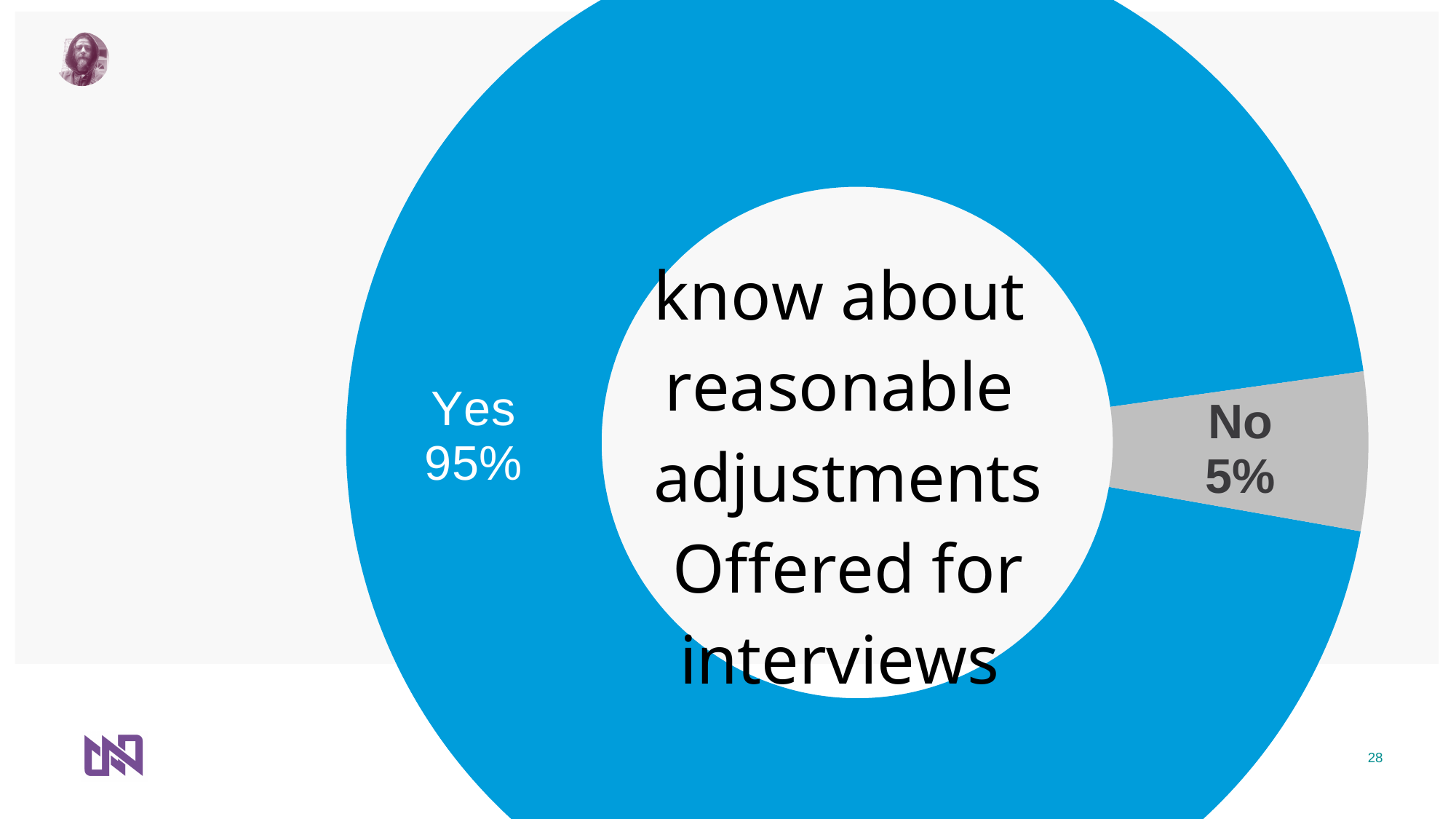
What colour is the Yes segment of the chart? Blue Which category has the smallest share of the chart? No Which category has the largest share of the chart? Yes Which is larger, the Yes share or the No share? Yes What is the difference in percentage points between the Yes and No shares? 90 What kind of chart is shown on the slide? Doughnut chart What share of the chart does the No slice represent? 5% How many categories are shown in the chart? 2 What percentage of respondents answered Yes to knowing about reasonable adjustments offered for interviews? 95% What percentage of respondents answered No? 5% What text appears in the centre of the doughnut chart? know about reasonable adjustments Offered for interviews